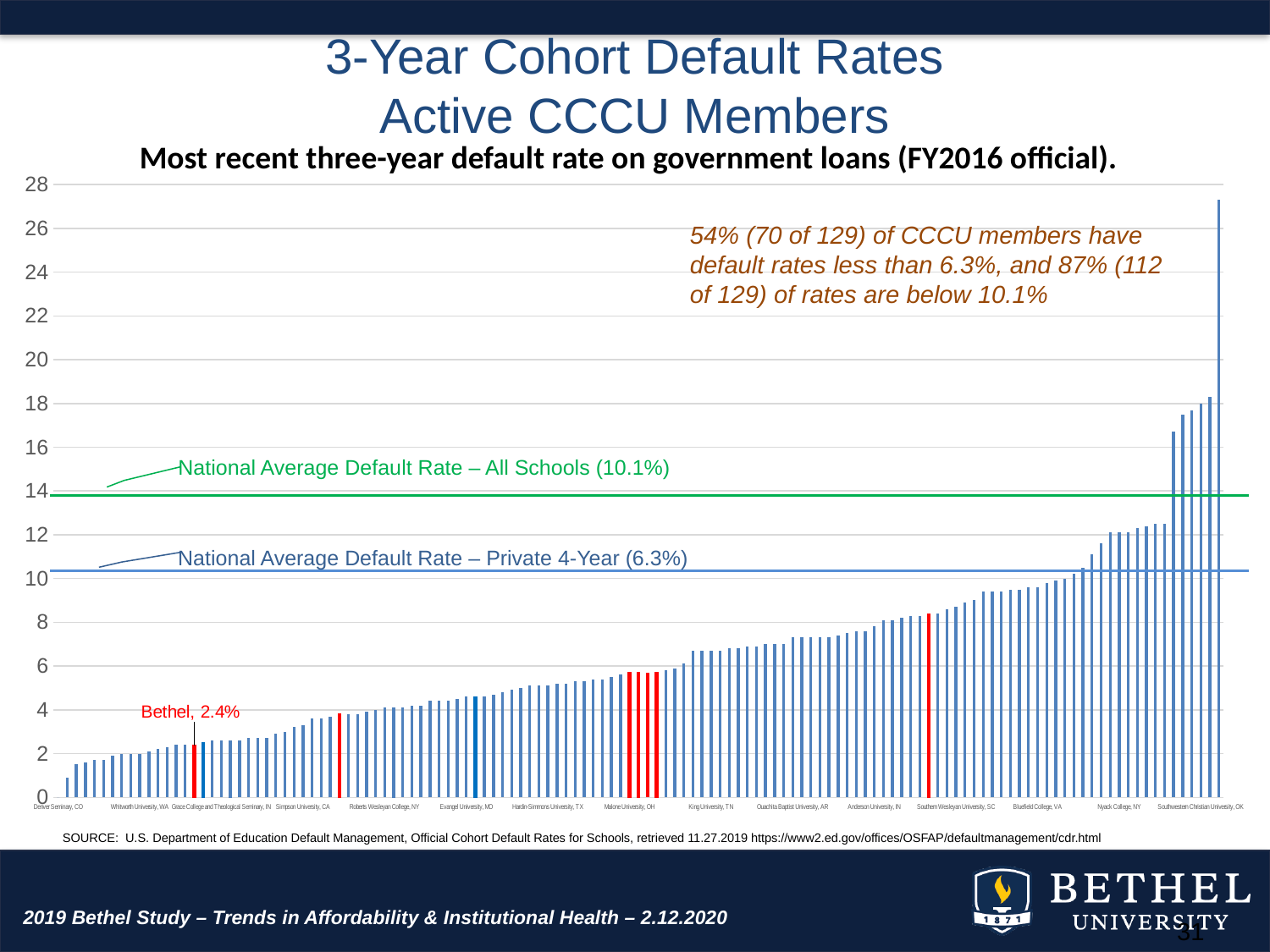
What is the National Average Default Rate for All Schools shown on the chart? 10.1% Is the value for Bethel greater or less than 2? greater Is the value for Southwestern Christian University, OK greater or less than 26? less Do the bar values rise or fall from left to right along the x axis? rise What is Bethel's 3-year cohort default rate shown on the chart? 2.4% What kind of chart is shown on the slide? bar chart Is the value for Bethel greater or less than 4? less How many CCCU members are included in the chart, according to the slide? 129 Which school has the lowest default rate on the chart? Denver Seminary, CO What is the National Average Default Rate for Private 4-Year schools shown on the chart? 6.3%